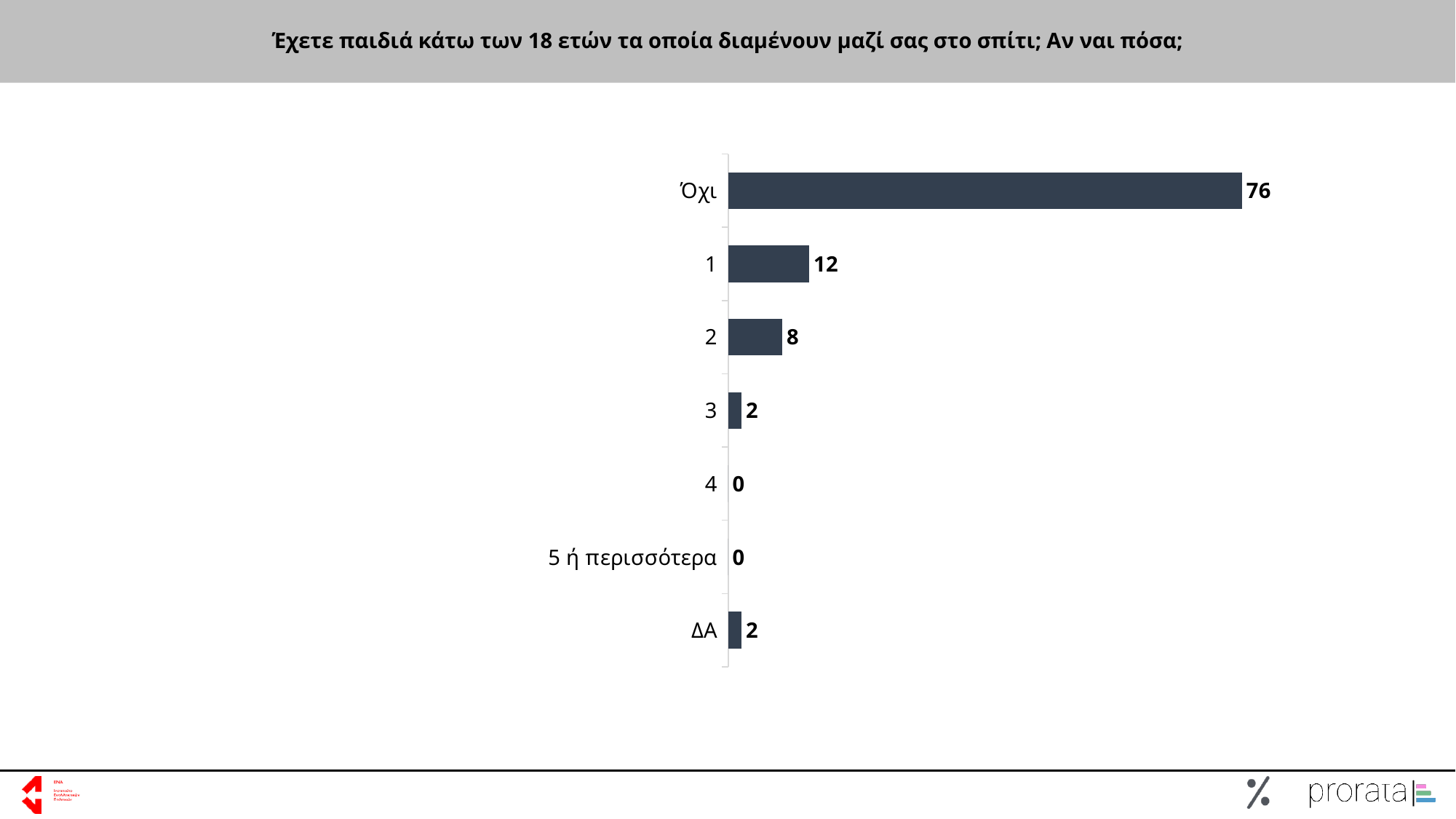
What is the value for the category "1"? 12 How many categories are shown in the chart? 7 Which is larger, the value for "2" or the value for "3"? 2 What is the value for "5 ή περισσότερα"? 0 What is the value for "ΔΑ"? 2 What is the value for the category "2"? 8 What kind of chart is shown on the slide? Bar chart What is the value for "Όχι"? 76 What is the title of the chart? Έχετε παιδιά κάτω των 18 ετών τα οποία διαμένουν μαζί σας στο σπίτι; Αν ναι πόσα; What is the difference between the values for "Όχι" and "1"? 64 Which category has the highest value? Όχι What is the difference between the values for "1" and "2"? 4